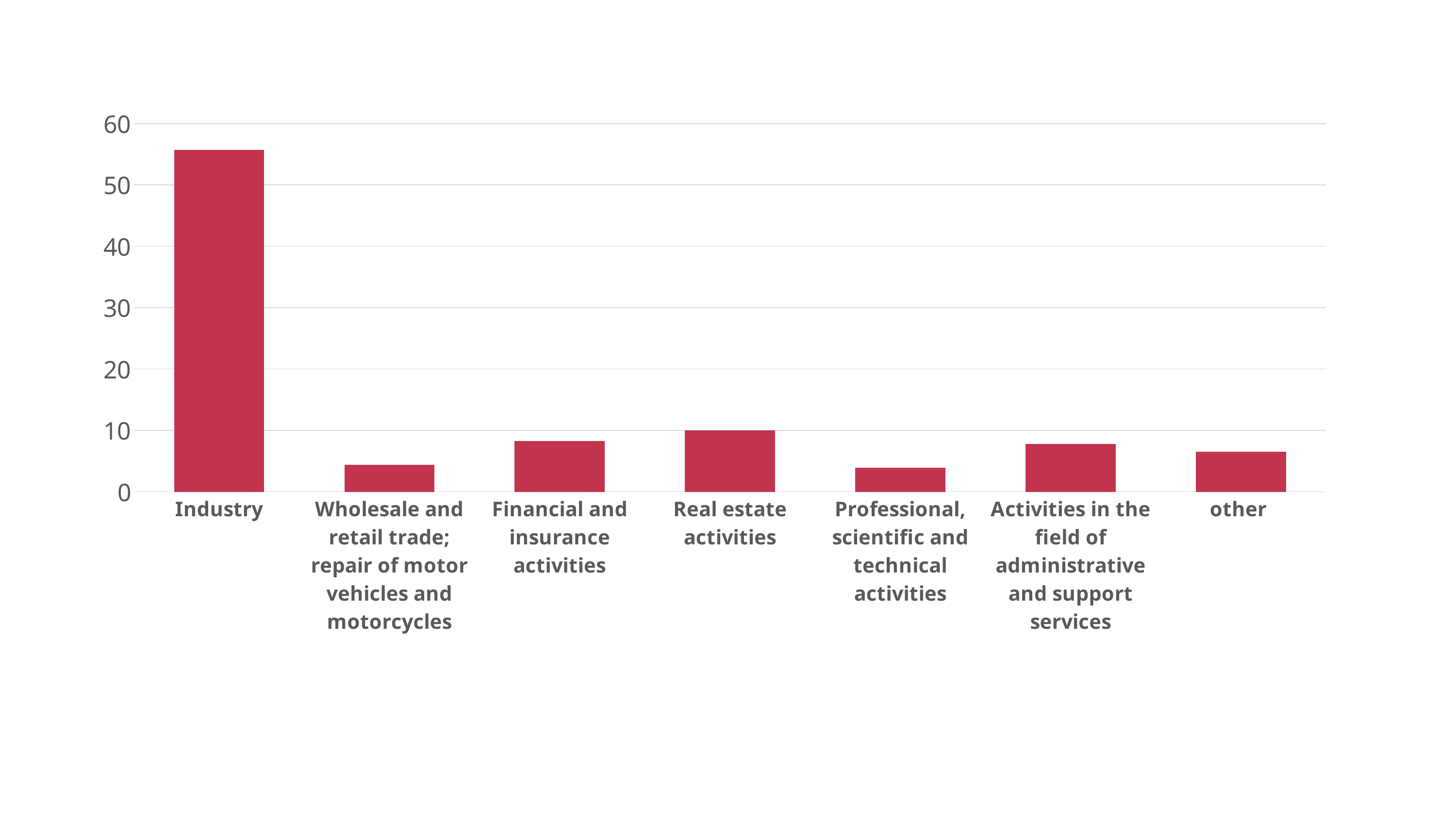
What colour are the bars in the chart? red How many categories are shown on the x axis of the chart? 7 Is the value for Industry greater or less than 50? greater Which category has the highest value in the chart? Industry Which is larger, the value for Real estate activities or the value for Professional, scientific and technical activities? Real estate activities What kind of chart is shown on the slide? bar chart Which is larger, the value for Financial and insurance activities or the value for Wholesale and retail trade; repair of motor vehicles and motorcycles? Financial and insurance activities Is the value for Financial and insurance activities greater or less than 10? less Is the value for Professional, scientific and technical activities greater or less than 10? less Which is larger, the value for Industry or the value for Real estate activities? Industry